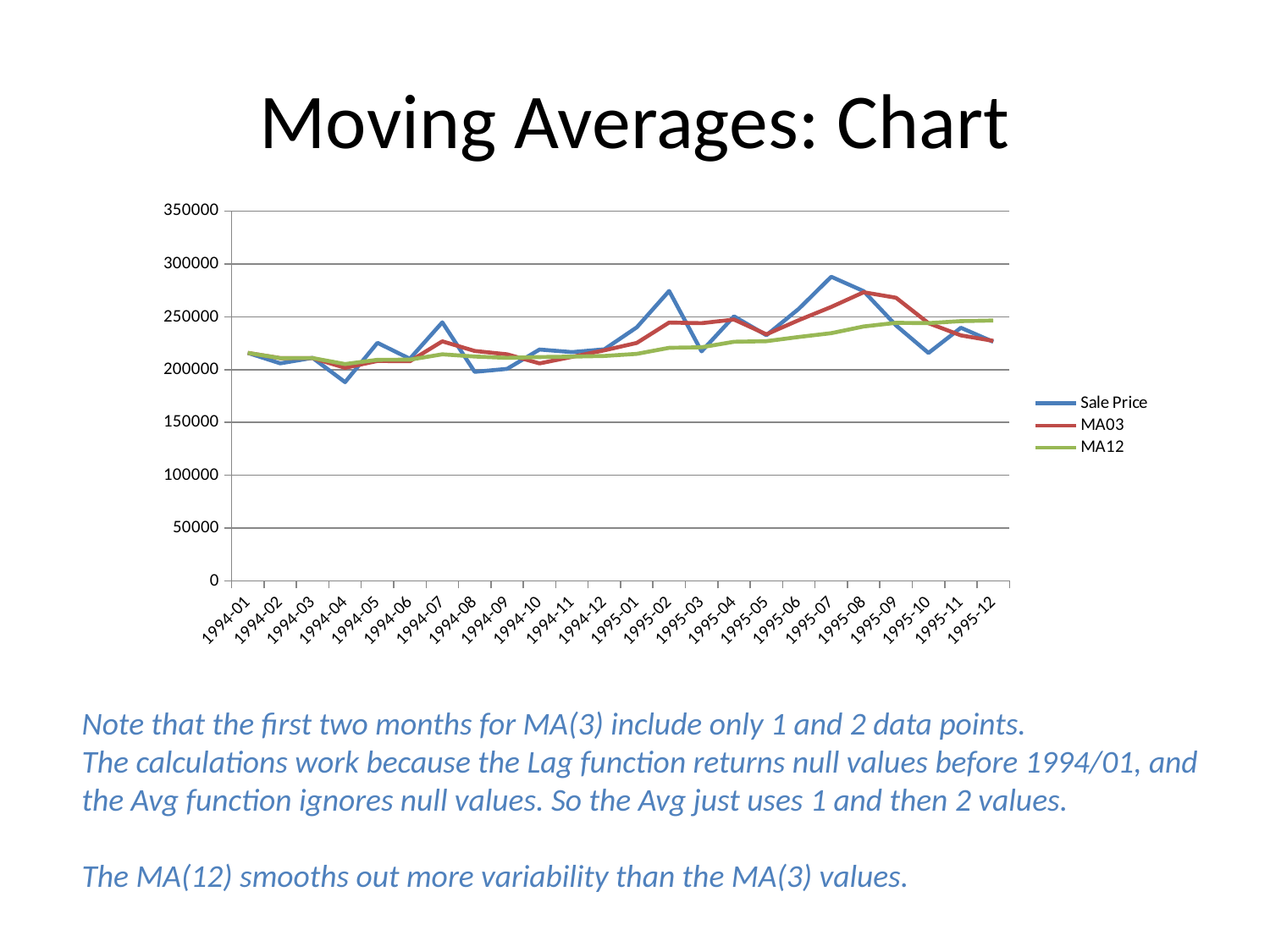
Does the MA12 series generally rise or fall from 1994-01 to 1995-12? Rise What is the title of the slide containing the chart? Moving Averages: Chart How many months are plotted along the x axis? 24 Is the Sale Price value for 1995-07 greater or less than 250000? greater How many series does the legend list? 3 Is the MA12 value for 1994-01 greater or less than 200000? greater In which month does the Sale Price series reach its lowest value? 1994-04 Is the Sale Price value for 1994-04 greater or less than 200000? less Which is larger: the Sale Price value for 1995-07 or for 1994-04? 1995-07 In which month does the Sale Price series reach its highest value? 1995-07 Which series is drawn in green? MA12 What kind of chart is shown on the slide? Line chart